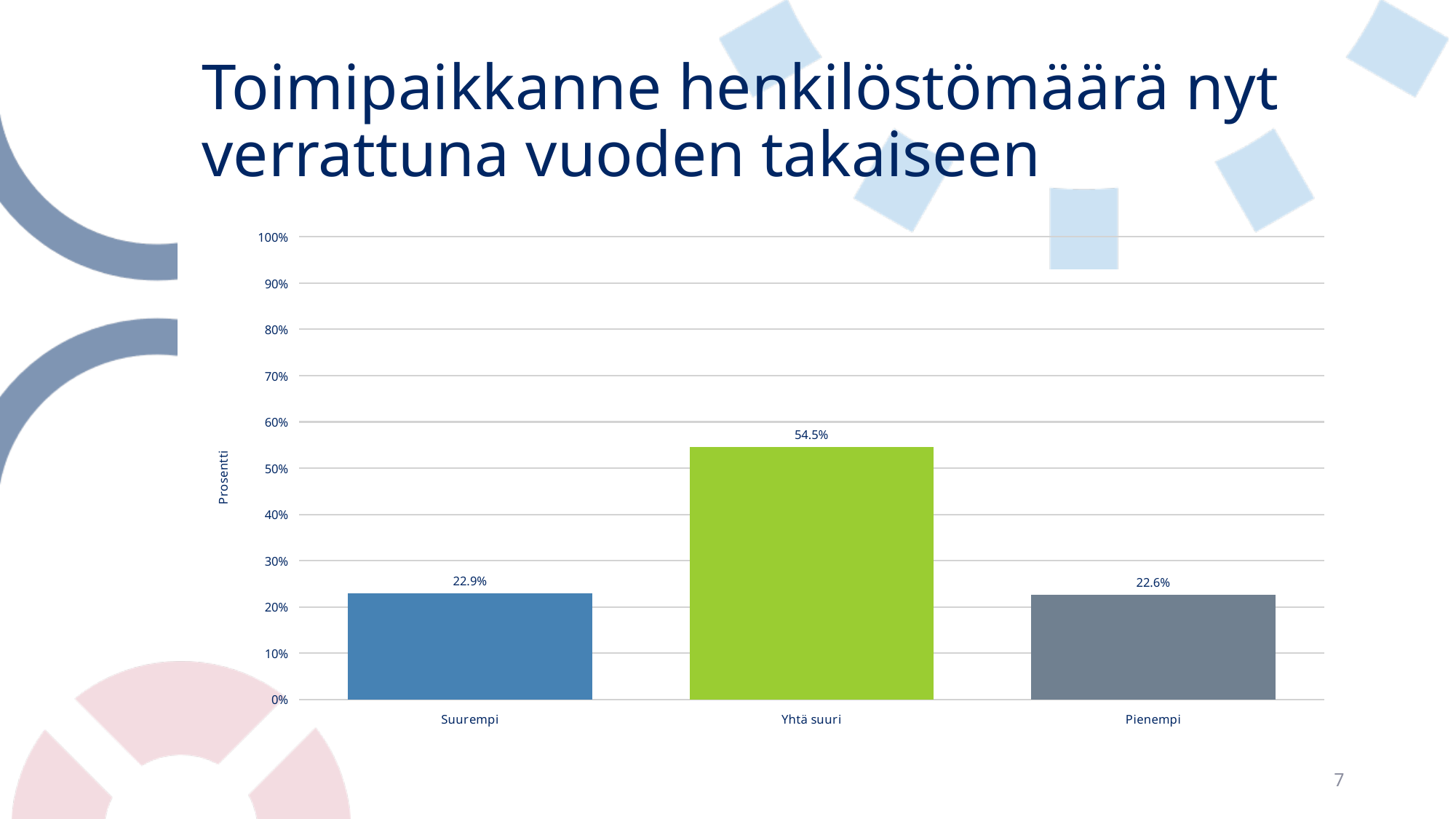
What is the value for Yhtä suuri? 54.5% What is the value for Suurempi? 22.9% What is the difference between the values for Suurempi and Pienempi? 0.3% What kind of chart is shown on the slide? bar chart Which category has the highest value? Yhtä suuri How many categories are shown on the x axis? 3 What is the difference between the values for Yhtä suuri and Suurempi? 31.6% What is the value for Pienempi? 22.6% Which is larger, the value for Yhtä suuri or the value for Pienempi? Yhtä suuri Is the value for Pienempi greater or less than 30%? less What is the label of the vertical axis? Prosentti Is the value for Yhtä suuri greater or less than 50%? greater